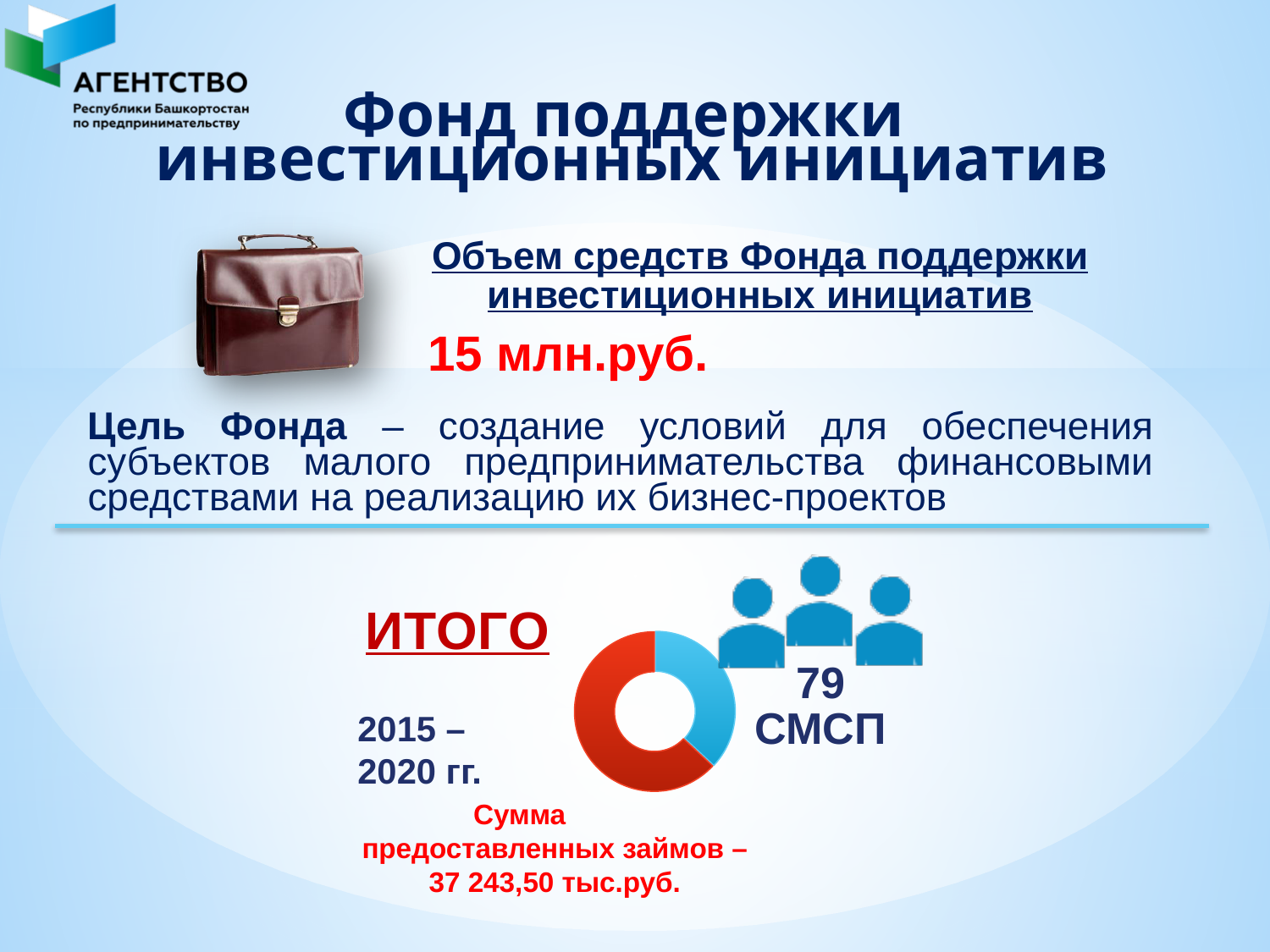
Which colour slice takes up the largest share of the pie chart? red How many slices does the pie chart have? 2 What number is printed next to the pie chart beside the people icons? 79 What kind of chart is shown on the slide? doughnut chart What two colours are used for the slices of the pie chart? red and blue Which colour slice takes up the smallest share of the pie chart? blue Which slice of the pie chart is larger, the red one or the blue one? red